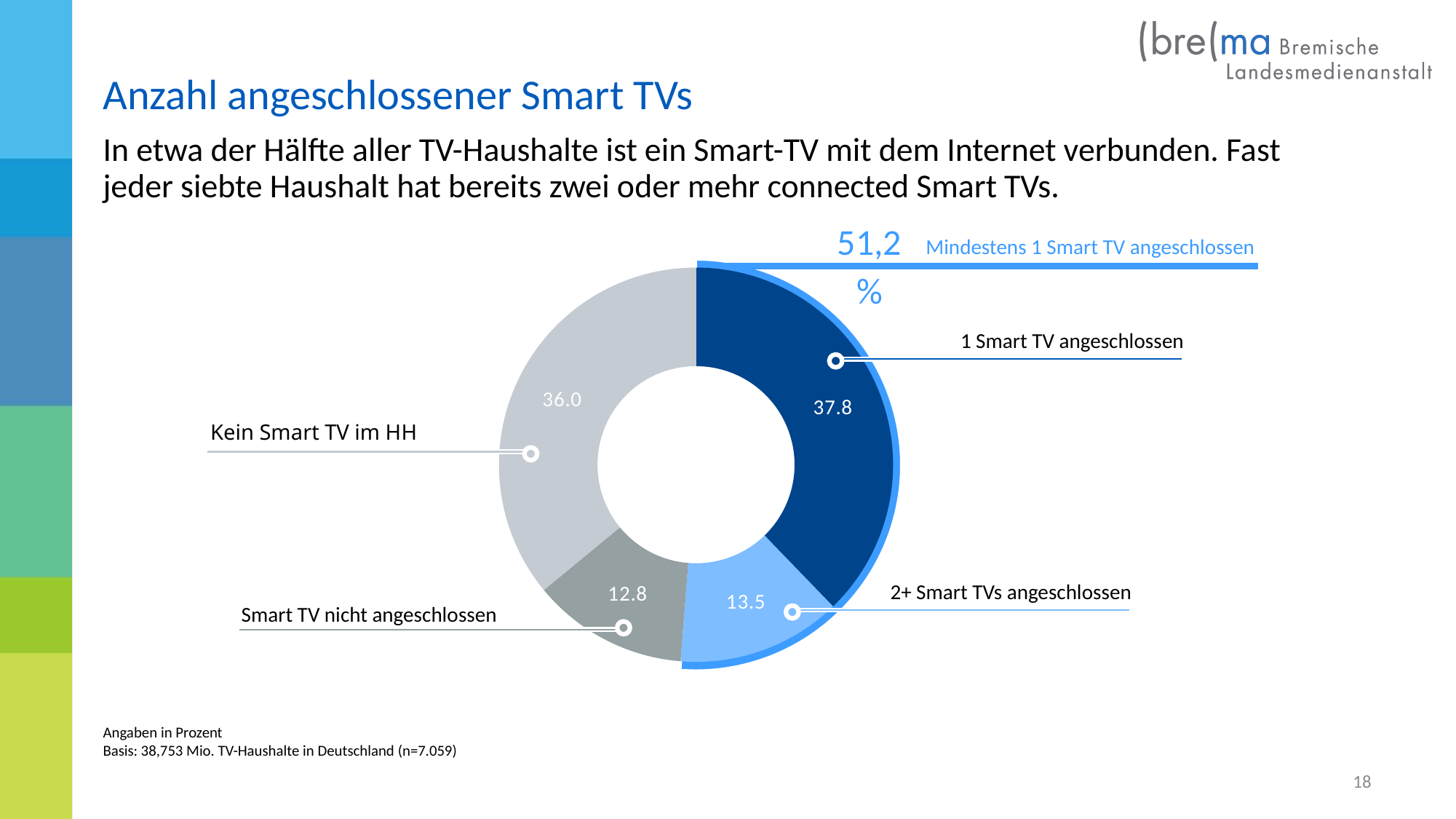
How many segments does the donut chart have? 4 What percentage is shown on the slide for "Mindestens 1 Smart TV angeschlossen"? 51,2 % What kind of chart is shown on the slide? Donut (pie) chart Which category has the smallest share of the donut chart? Smart TV nicht angeschlossen What is the difference between the values for "1 Smart TV angeschlossen" and "Kein Smart TV im HH"? 1.8 What is the combined value of "1 Smart TV angeschlossen" and "2+ Smart TVs angeschlossen"? 51.3 What is the title of the slide containing the chart? Anzahl angeschlossener Smart TVs Which category has the largest share of the donut chart? 1 Smart TV angeschlossen What is the value for "Kein Smart TV im HH"? 36.0 What is the value for "2+ Smart TVs angeschlossen"? 13.5 What is the value for "1 Smart TV angeschlossen"? 37.8 What is the value for "Smart TV nicht angeschlossen"? 12.8